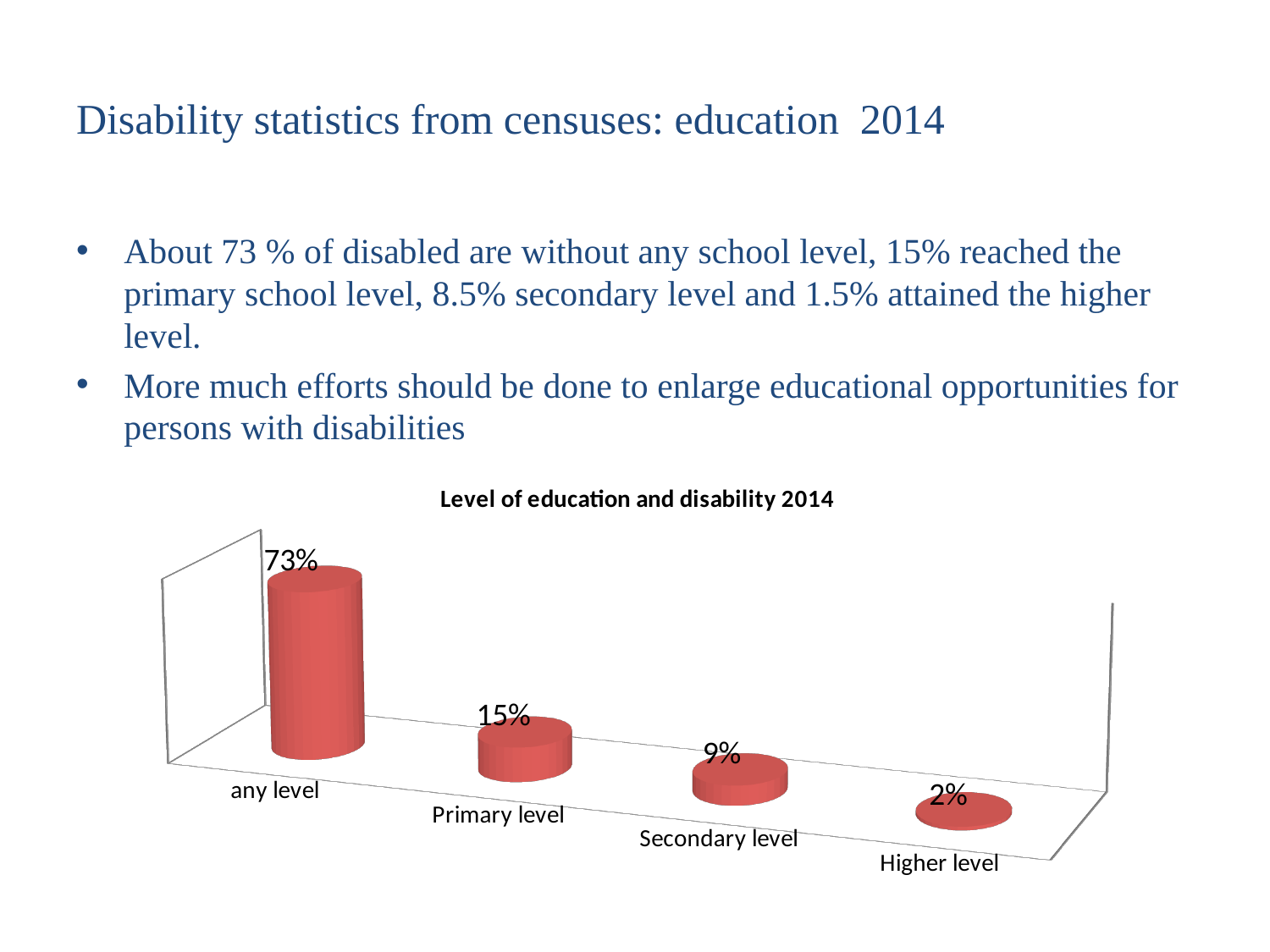
What kind of chart is shown on the slide? bar chart What is the value for Secondary level? 9% What is the value for Primary level? 15% What is the difference between the values for any level and Primary level? 58% What is the value for any level? 73% What is the title of the chart? Level of education and disability 2014 Which category has the highest value? any level Which is larger, the value for Primary level or the value for Secondary level? Primary level How many categories are shown in the chart? 4 What is the value for Higher level? 2% What is the difference between the values for Secondary level and Higher level? 7% Which category has the lowest value? Higher level